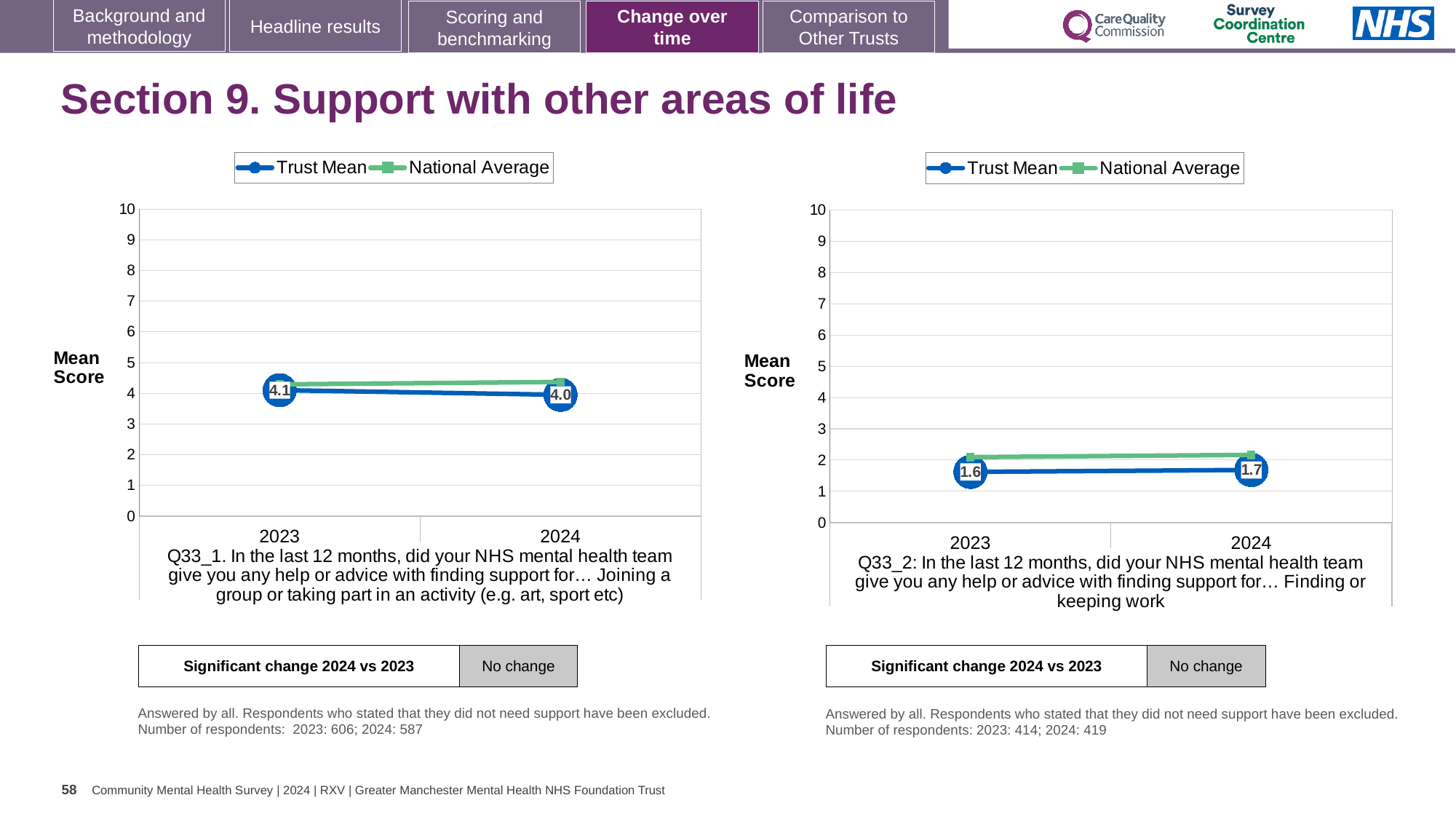
In the left chart (Q33_1), what is the Trust Mean for 2024? 4.0 In the left chart (Q33_1), does the Trust Mean rise or fall from 2023 to 2024? fall How many years are shown on the x axis of the left chart (Q33_1)? 2 What kind of chart is the left chart (Q33_1)? line chart In the left chart (Q33_1), what is the Trust Mean for 2023? 4.1 How many series does the legend of the right chart (Q33_2) list? 2 In the right chart (Q33_2), is the National Average for 2024 greater or less than 2? greater In the left chart (Q33_1), is the National Average for 2024 greater or less than 5? less In the left chart (Q33_1), what is the difference between the Trust Mean for 2023 and 2024? 0.1 In the right chart (Q33_2), does the Trust Mean rise or fall from 2023 to 2024? rise In the right chart (Q33_2), what is the Trust Mean for 2024? 1.7 In the right chart (Q33_2), what is the Trust Mean for 2023? 1.6